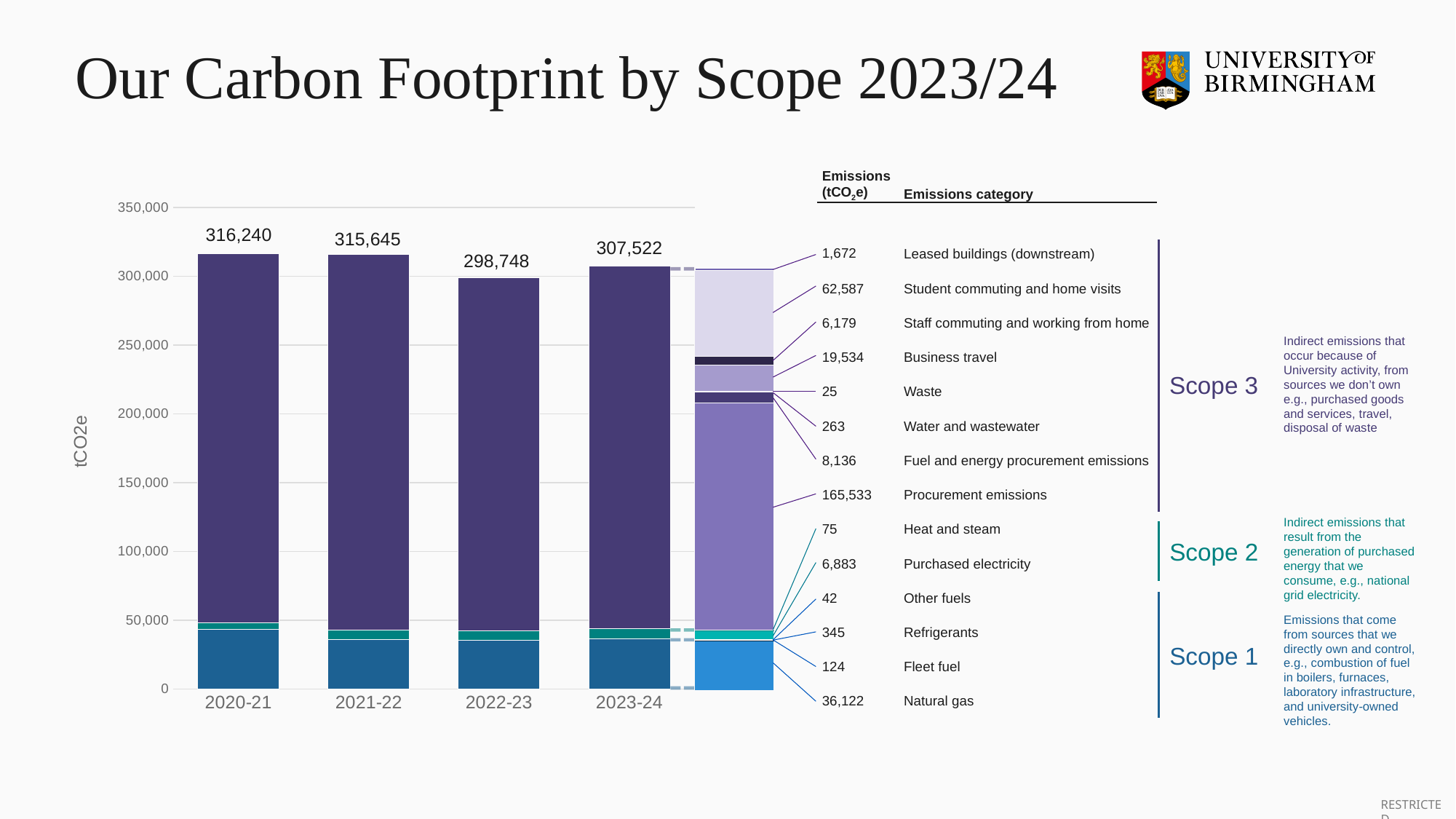
Which year has the lowest total carbon footprint? 2022-23 In the 2023-24 breakdown, what are the emissions for Procurement emissions? 165,533 Which is larger, the total for 2021-22 or the total for 2023-24? 2021-22 What is the difference between the totals for 2020-21 and 2021-22? 595 In the 2023-24 breakdown, which emissions category has the smallest value? Waste How many years are shown on the x axis of the bar chart? 4 What is the difference between the totals for 2023-24 and 2022-23? 8,774 Is the total for 2022-23 greater or less than 300,000? less What is the total carbon footprint shown for 2023-24? 307,522 What kind of chart is used to show the carbon footprint by year? bar chart Which year has the highest total carbon footprint? 2020-21 What is the total carbon footprint shown for 2020-21? 316,240